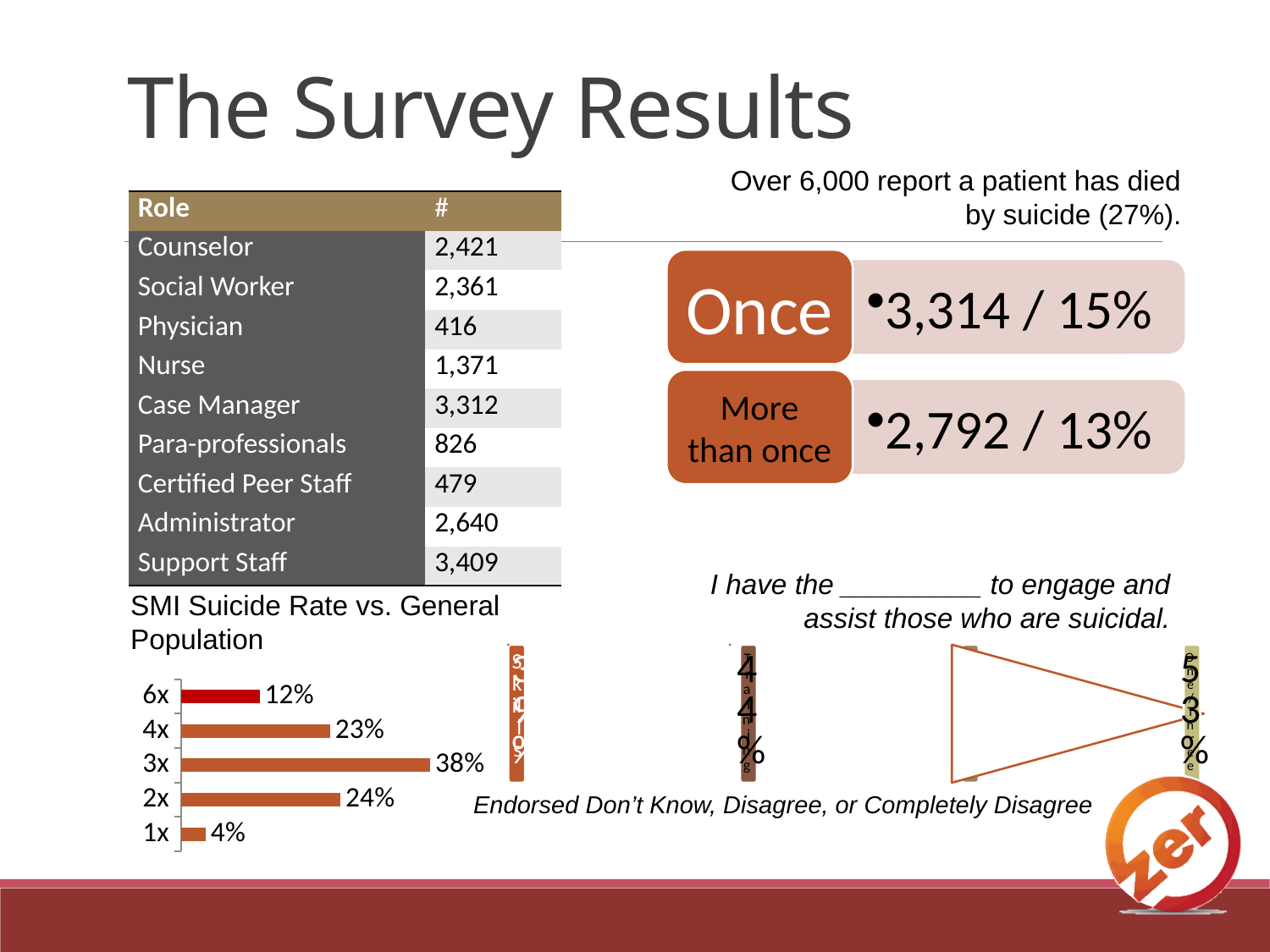
In the SMI Suicide Rate vs. General Population chart, what is the value for 2x? 24% What kind of chart is the SMI Suicide Rate vs. General Population chart? Bar chart In the SMI Suicide Rate vs. General Population chart, what is the value for 6x? 12% In the SMI Suicide Rate vs. General Population chart, which category has the highest value? 3x In the SMI Suicide Rate vs. General Population chart, what is the difference between the values for 3x and 4x? 15% How many categories are shown in the SMI Suicide Rate vs. General Population chart? 5 In the SMI Suicide Rate vs. General Population chart, which is larger, the value for 4x or the value for 6x? 4x In the SMI Suicide Rate vs. General Population chart, which category has the lowest value? 1x In the SMI Suicide Rate vs. General Population chart, what is the difference between the values for 2x and 1x? 20% In the SMI Suicide Rate vs. General Population chart, what is the value for 3x? 38% In the SMI Suicide Rate vs. General Population chart, what is the value for 1x? 4% In the SMI Suicide Rate vs. General Population chart, which bar is coloured differently (dark red) from the others? 6x